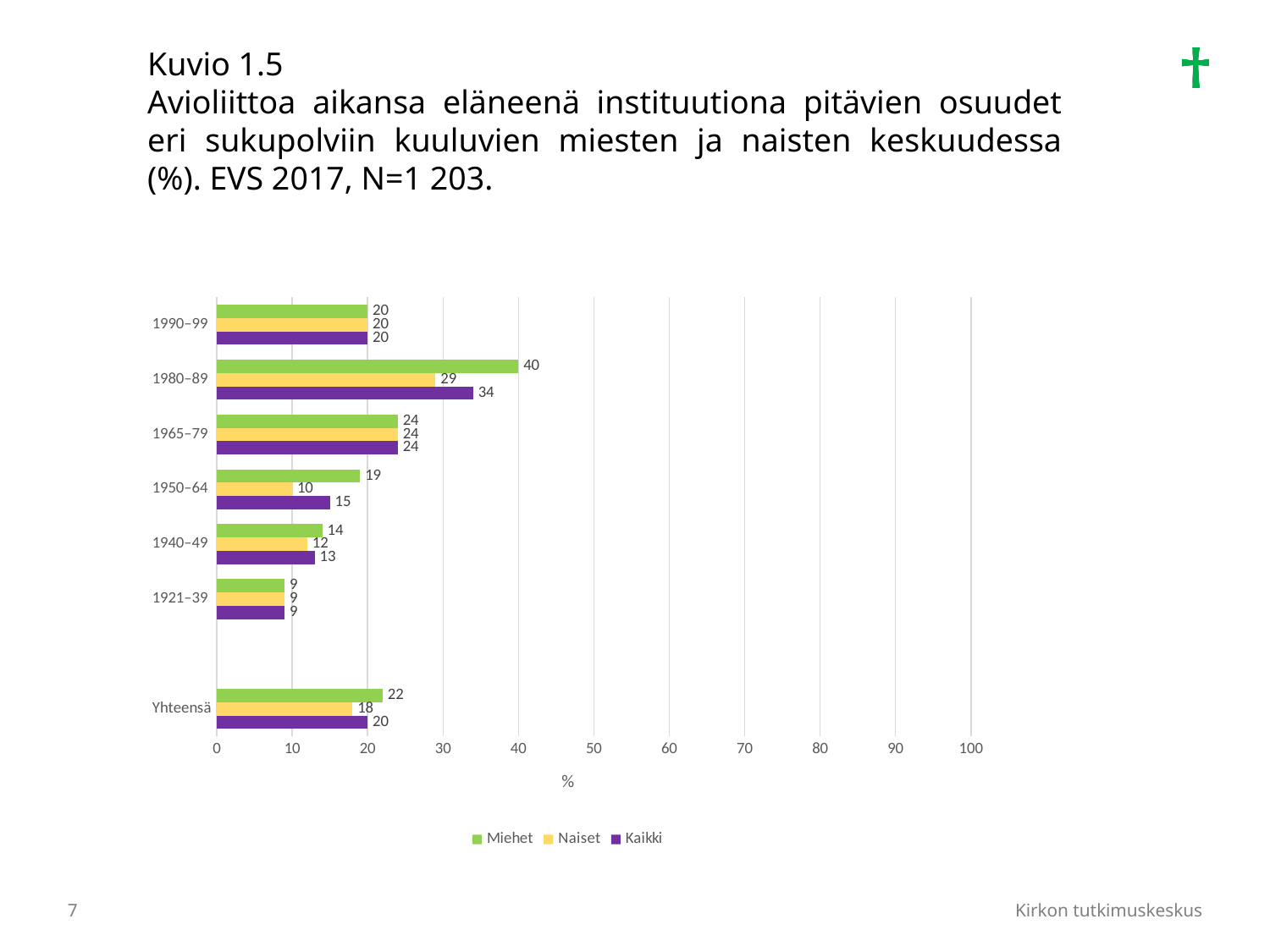
What is the Naiset value for the 1950–64 generation? 10 Which is larger for 1950–64, the Miehet value or the Naiset value? Miehet What is the Miehet value for the 1980–89 generation? 40 Which generation has the highest Kaikki value? 1980–89 What is the difference between the Miehet and Naiset values for 1980–89? 11 Which series is shown in purple according to the legend? Kaikki Is the Kaikki value for 1980–89 greater or less than 30? greater What is the Kaikki value for Yhteensä? 20 Which generation has the lowest Miehet value? 1921–39 How many series does the legend list? 3 What kind of chart is shown on the slide? bar chart How many categories are shown on the vertical axis, including Yhteensä? 7